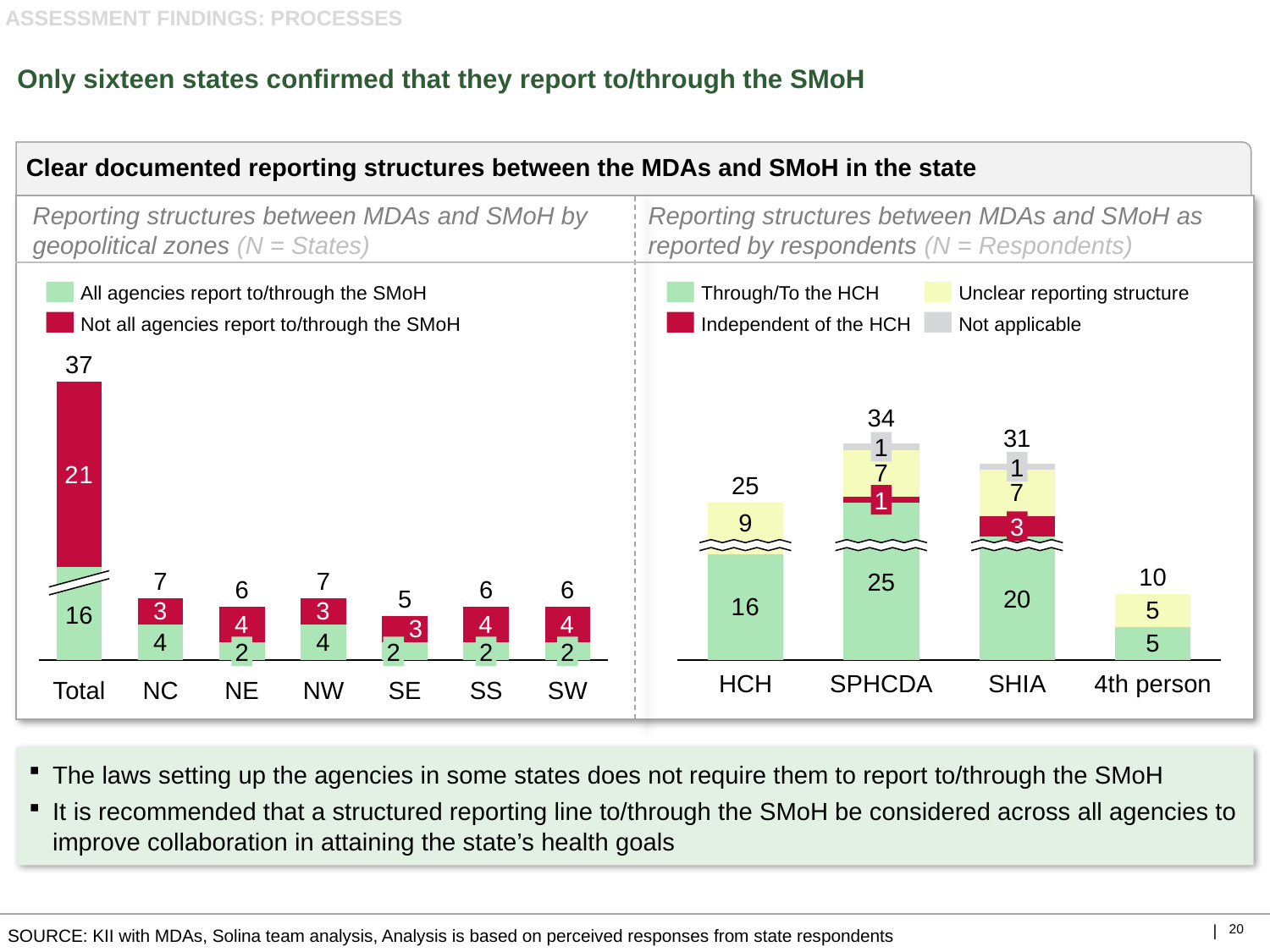
In the left chart (by geopolitical zones), how many series does the legend list? 2 In the right chart (as reported by respondents), which respondent group has the highest bar total? SPHCDA In the left chart (by geopolitical zones), what is the total for the Total bar? 37 In the right chart (as reported by respondents), what is the total for the SHIA bar? 31 In the right chart (as reported by respondents), how many series does the legend list? 4 In the right chart (as reported by respondents), is the 'Independent of the HCH' value larger for SHIA or for SPHCDA? SHIA In the left chart (by geopolitical zones), how many states in NE have not all agencies reporting to/through the SMoH? 4 In the left chart (by geopolitical zones), what is the difference between the 'Not all agencies' and 'All agencies' values in the Total bar? 5 In the right chart (as reported by respondents), what is the 'Through/To the HCH' value for SPHCDA? 25 In the left chart (by geopolitical zones), which zone (excluding Total) has the lowest bar total? SE In the left chart (by geopolitical zones), how many categories are shown on the x axis? 7 What kind of chart is the right chart (as reported by respondents)? Stacked bar chart